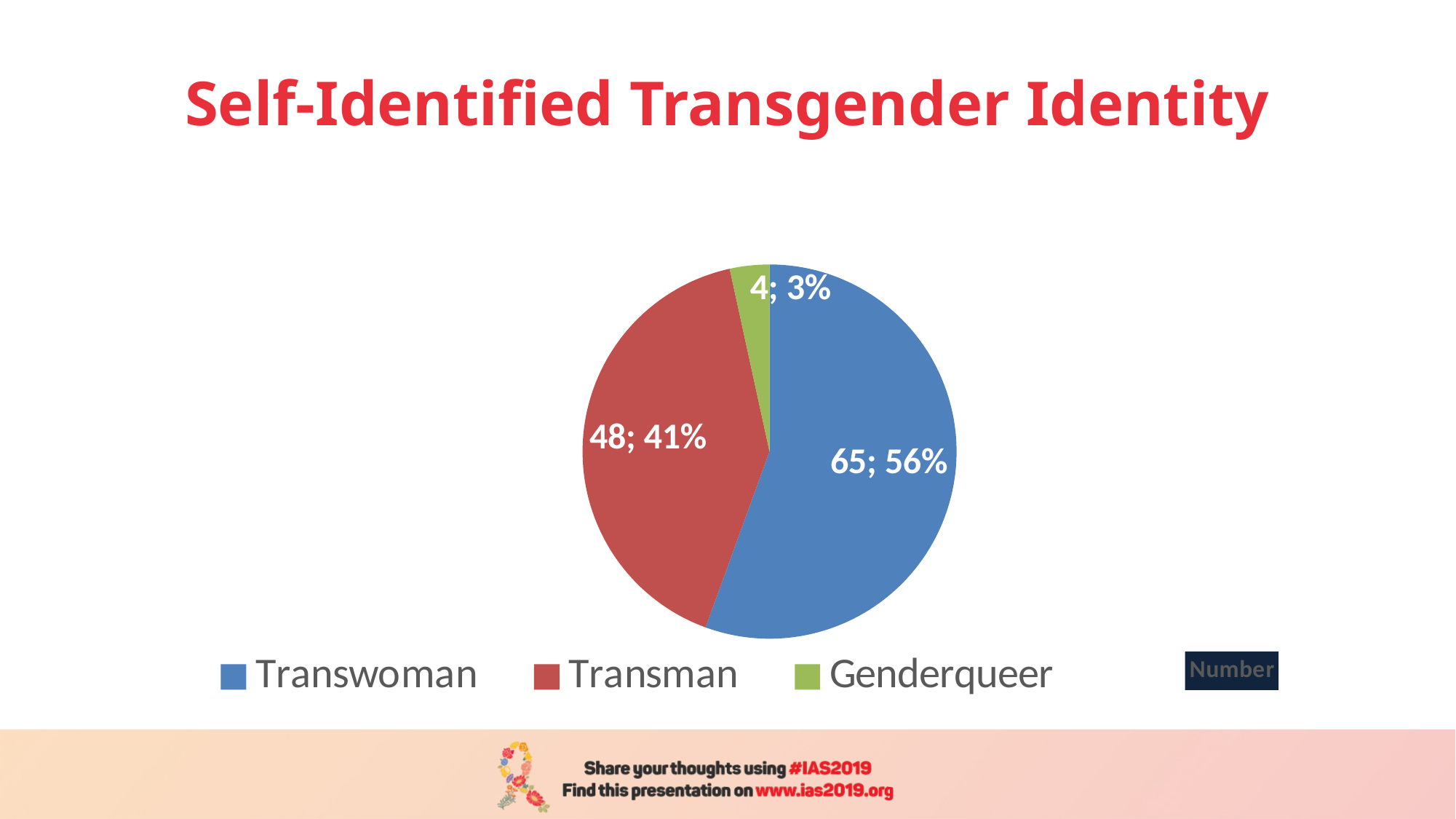
What is the number for Genderqueer? 4 What kind of chart is shown on the slide? pie chart Which category has the largest slice? Transwoman What is the number for Transwoman? 65 What is the difference between the numbers for Transwoman and Transman? 17 What share of the pie does Genderqueer represent? 3% What is the number for Transman? 48 How many slices does the pie chart have? 3 What share of the pie does Transman represent? 41% What colour is the Transman slice? red Which is larger, the number for Transman or the number for Genderqueer? Transman Which category has the smallest slice? Genderqueer